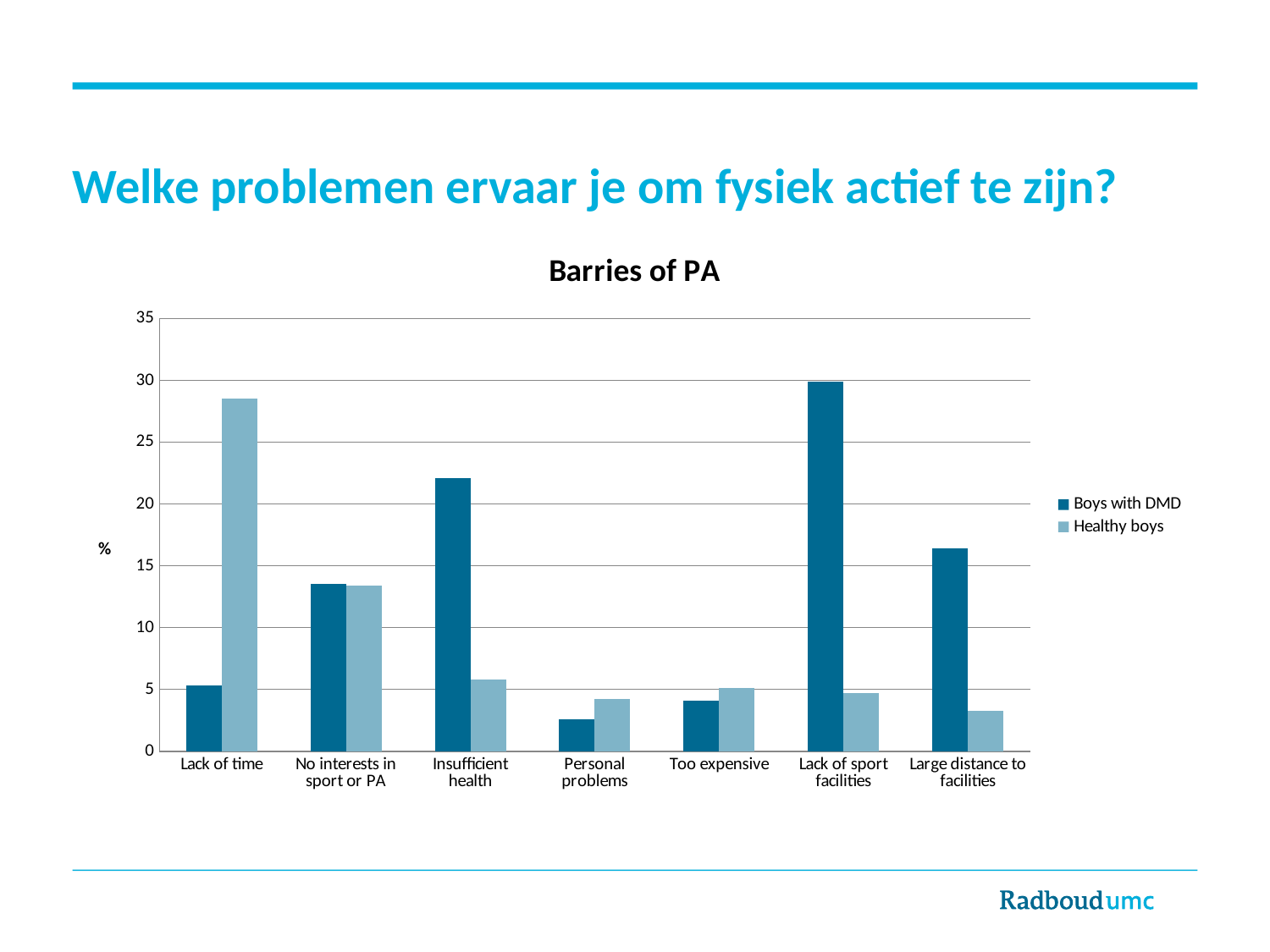
How many series does the legend list? 2 What kind of chart is shown on the slide? bar chart What is the title of the chart? Barries of PA For Healthy boys, which barrier has the highest value? Lack of time For Large distance to facilities, which series has the larger value, Boys with DMD or Healthy boys? Boys with DMD Is the value for Healthy boys for Lack of time greater or less than 25? greater For Healthy boys, which barrier has the lowest value? Large distance to facilities For Boys with DMD, which barrier has the highest value? Lack of sport facilities How many barrier categories are shown on the x axis? 7 For Boys with DMD, which barrier has the lowest value? Personal problems Is the value for Boys with DMD for Insufficient health greater or less than 20? greater For Lack of time, which series has the larger value, Boys with DMD or Healthy boys? Healthy boys